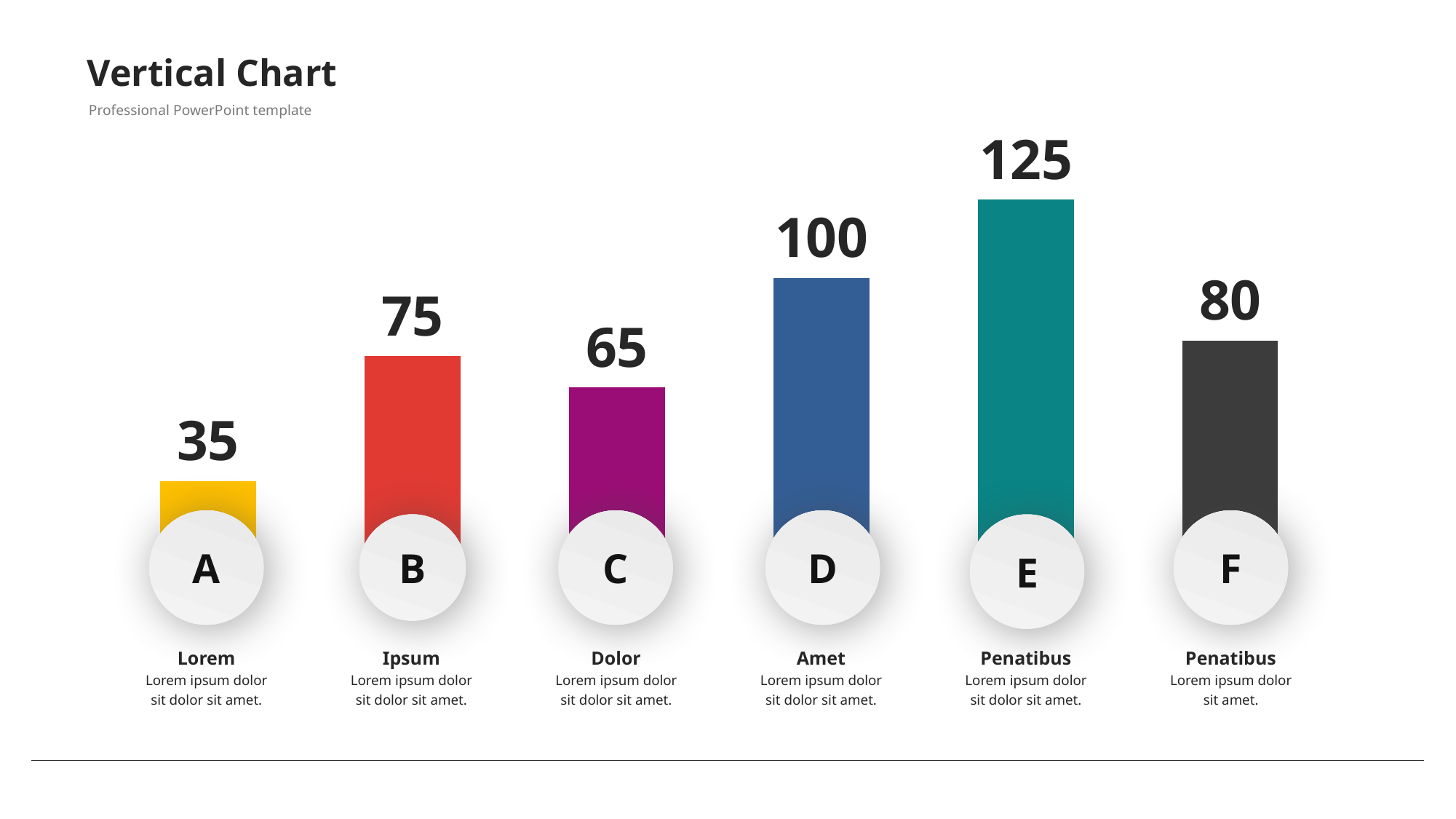
What is the difference between the values for bars E and D? 25 Which bar has the highest value? E What is the difference between the values for bars B and C? 10 Which bar has the lowest value? A What is the value for bar D? 100 What is the value for bar F? 80 Which is larger, the value for bar B or the value for bar F? F What colour is bar E? teal How many bars are shown in the chart? 6 What is the value for bar A? 35 What is the title of the slide? Vertical Chart What kind of chart is shown on the slide? bar chart